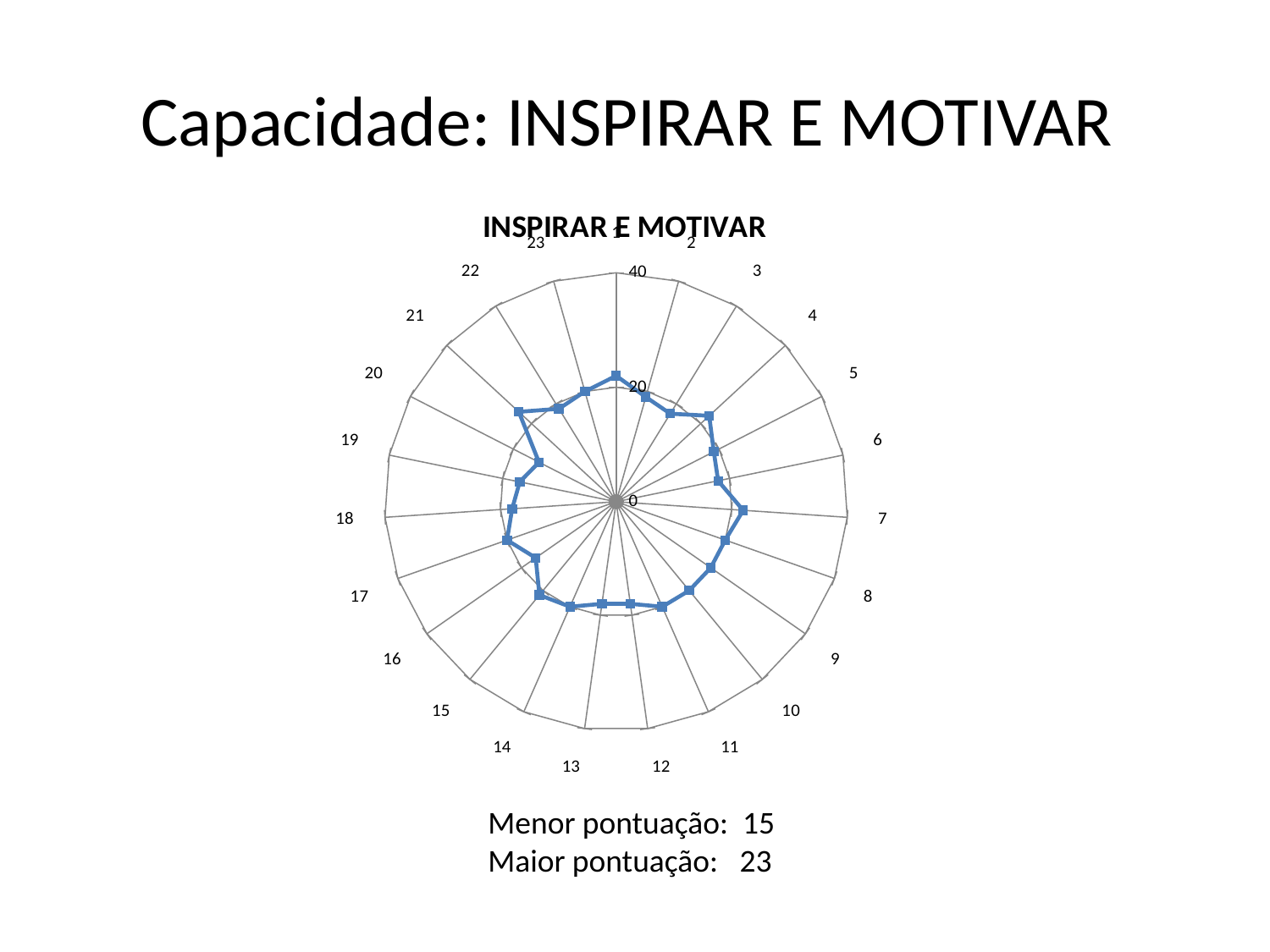
Is the value for category 7 greater or less than 40? less Is the value for category 21 greater or less than 20? greater What kind of chart is shown on the slide? Radar chart Is the value for category 1 greater or less than 40? less What is the highest value shown on the chart's radial axis? 40 How many categories are plotted around the radar chart? 23 How many data series are plotted on the chart? 1 What is the title of the chart? INSPIRAR E MOTIVAR